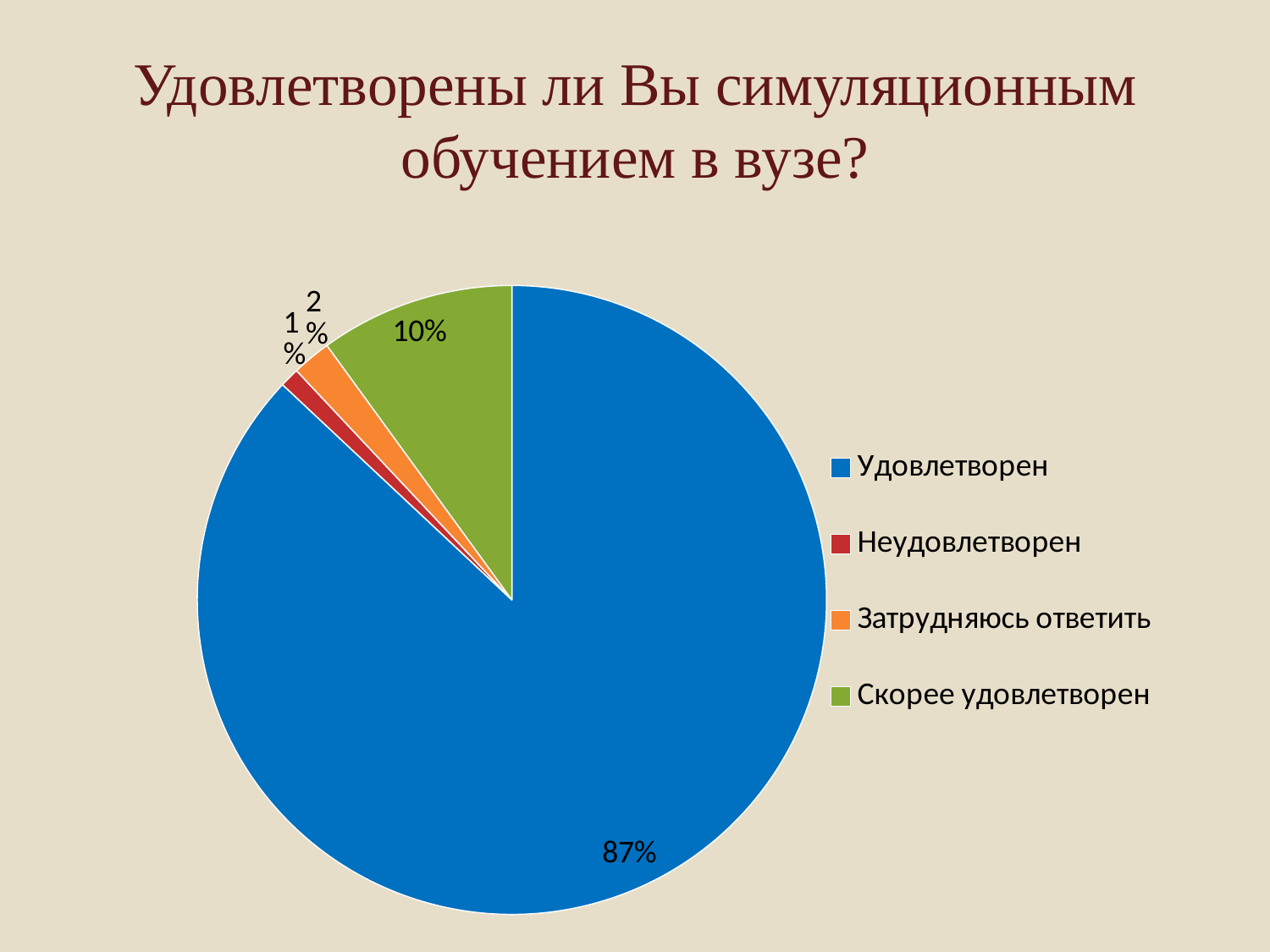
Which is larger, the slice for "Затрудняюсь ответить" or the slice for "Скорее удовлетворен"? Скорее удовлетворен Which category has the largest slice of the pie? Удовлетворен What kind of chart is shown on the slide? Pie chart What share of the pie does "Скорее удовлетворен" have? 10% What share of the pie does "Удовлетворен" have? 87% How many categories does the pie chart show? 4 What share of the pie does "Затрудняюсь ответить" have? 2% Which colour represents "Скорее удовлетворен" in the legend? Green Which category has the smallest slice of the pie? Неудовлетворен What is the difference in percentage points between "Удовлетворен" and "Скорее удовлетворен"? 77 What is the title of the slide? Удовлетворены ли Вы симуляционным обучением в вузе?